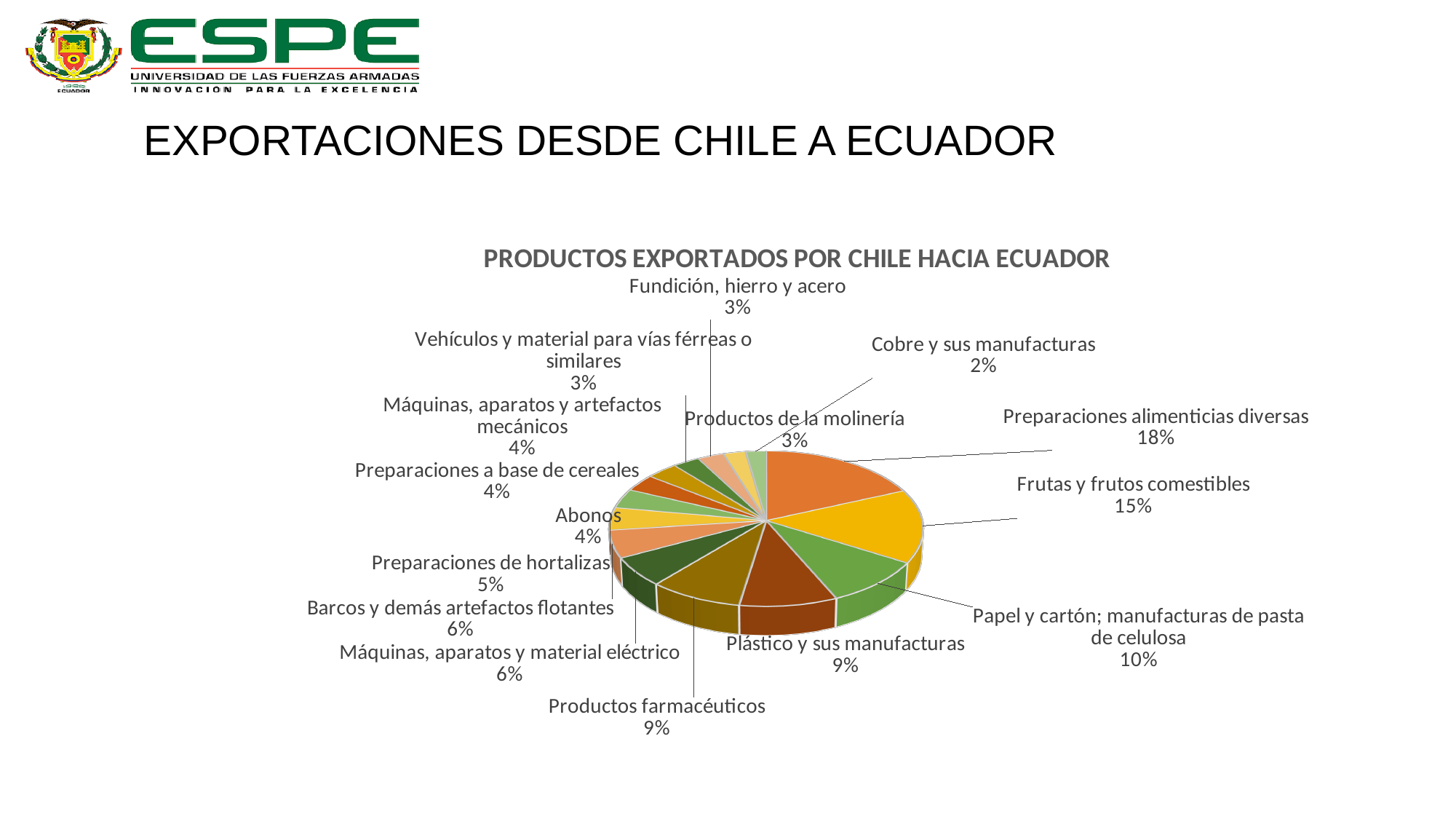
What is the title of the chart? PRODUCTOS EXPORTADOS POR CHILE HACIA ECUADOR What percentage is shown for Abonos? 4% What type of chart is shown on the slide? Pie chart How many categories are shown in the pie chart? 15 What share of the pie does Preparaciones alimenticias diversas represent? 18% What is the difference in percentage points between Preparaciones alimenticias diversas and Frutas y frutos comestibles? 3 Which category has the smallest share of the pie? Cobre y sus manufacturas Which is larger, the share for Barcos y demás artefactos flotantes or the share for Preparaciones de hortalizas? Barcos y demás artefactos flotantes Which category has the largest share of the pie? Preparaciones alimenticias diversas What percentage is shown for Productos farmacéuticos? 9% What percentage is shown for Papel y cartón; manufacturas de pasta de celulosa? 10% What percentage is shown for Frutas y frutos comestibles? 15%